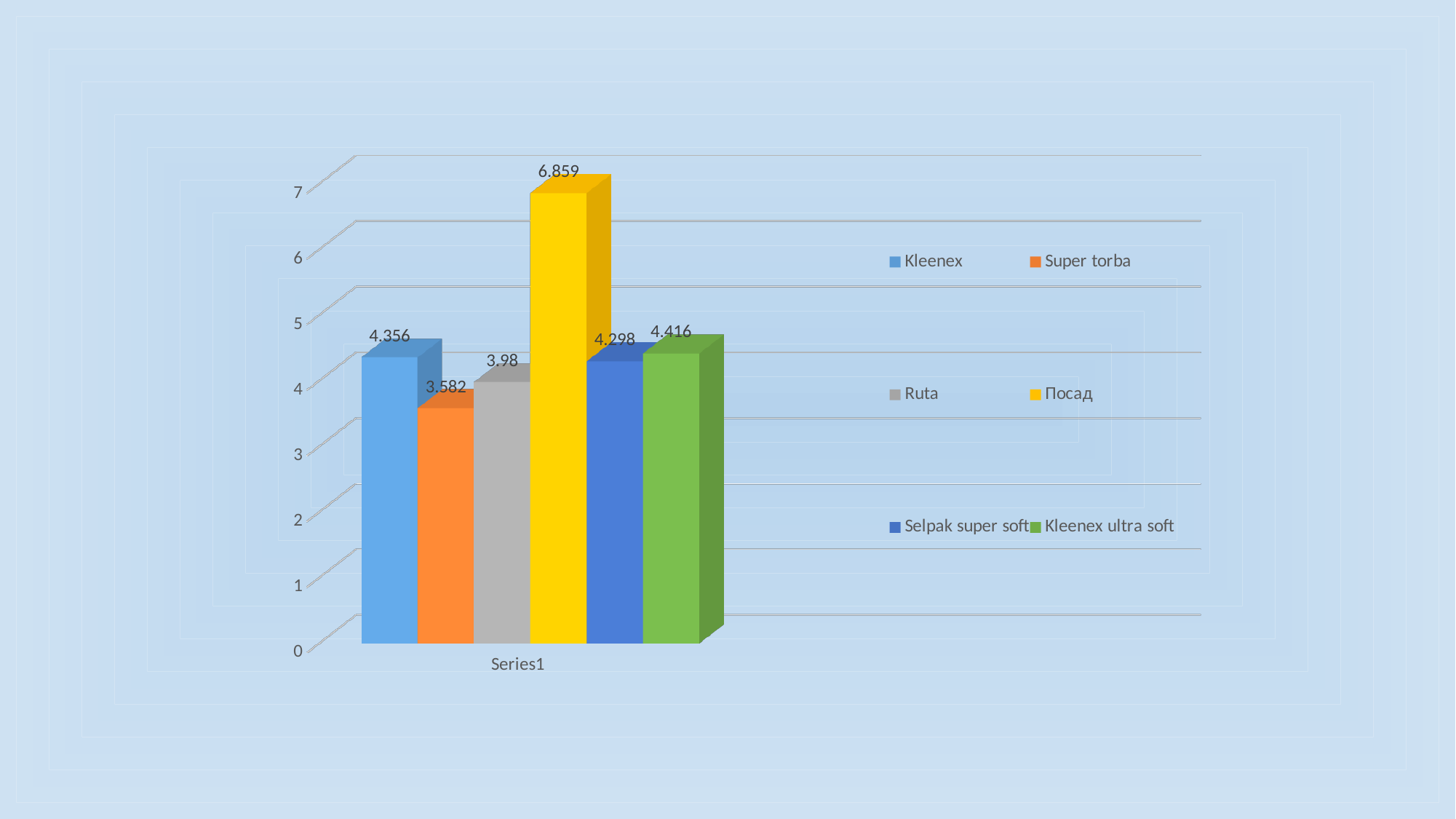
How many series does the legend list? 6 What is the value for Kleenex? 4.356 What is the difference between the values for Посад and Kleenex? 2.503 What kind of chart is shown on the slide? Bar chart What is the value for Посад? 6.859 Which series has the lowest value? Super torba What is the value for Selpak super soft? 4.298 What is the value for Super torba? 3.582 What is the value for Kleenex ultra soft? 4.416 Which is larger, the value for Kleenex or the value for Ruta? Kleenex Which series has the highest value? Посад What is the value for Ruta? 3.98